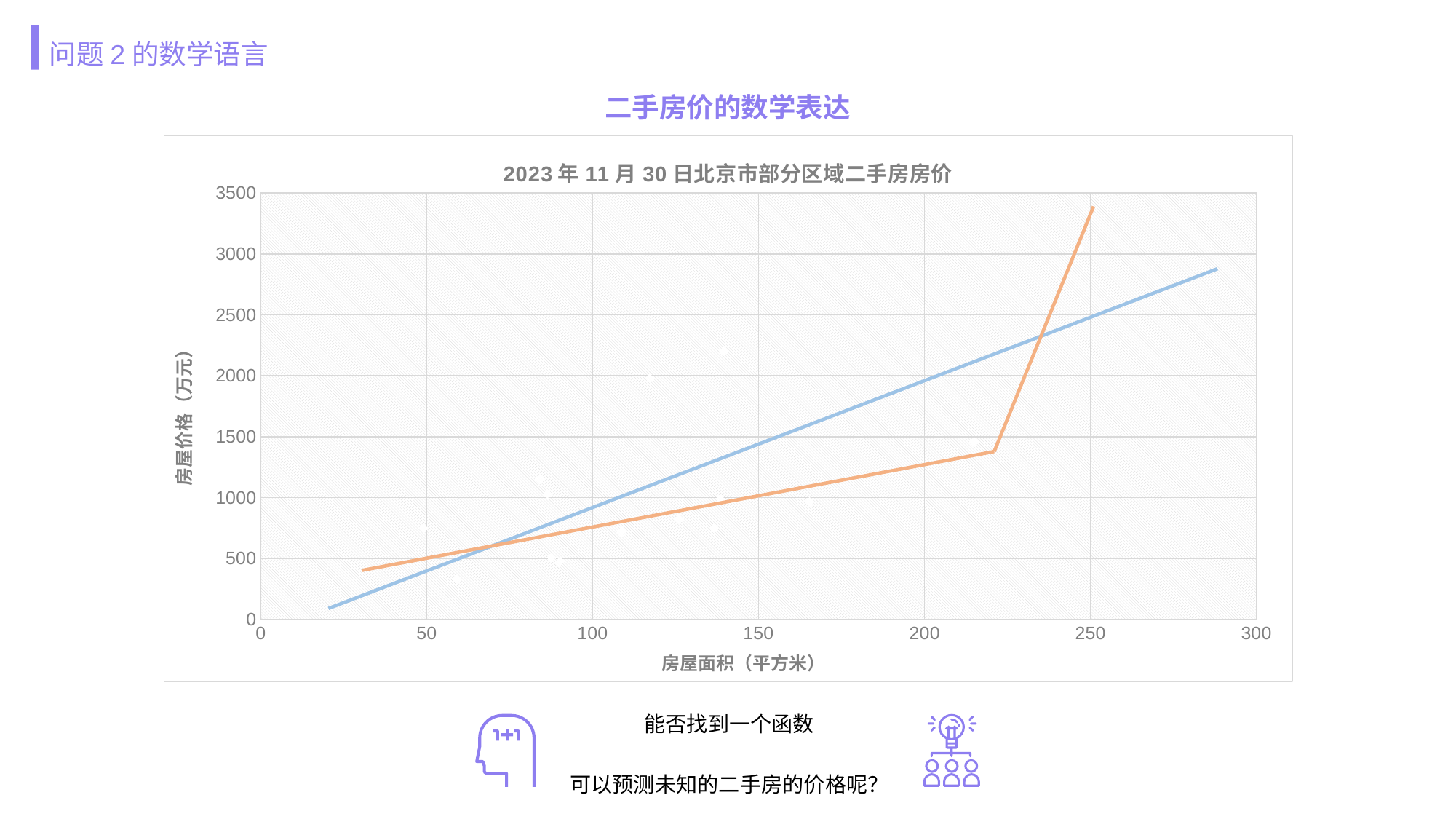
How many lines are plotted on the chart? 2 Is the highest value reached by the orange line greater or less than 3000? greater What is the title printed inside the chart? 2023 年 11 月 30 日北京市部分区域二手房房价 What is the label of the vertical axis? 房屋价格（万元） Does the orange line rise or fall as 房屋面积 increases? rise Does the blue line rise or fall as 房屋面积 increases? rise What kind of chart is shown on the slide? line chart Is the highest value reached by the blue line greater or less than 3000? less Is the value of the orange line at 房屋面积 = 220 greater or less than 1500? less At 房屋面积 = 250, which line is higher, the blue line or the orange line? orange line At 房屋面积 = 150, which line is higher, the blue line or the orange line? blue line